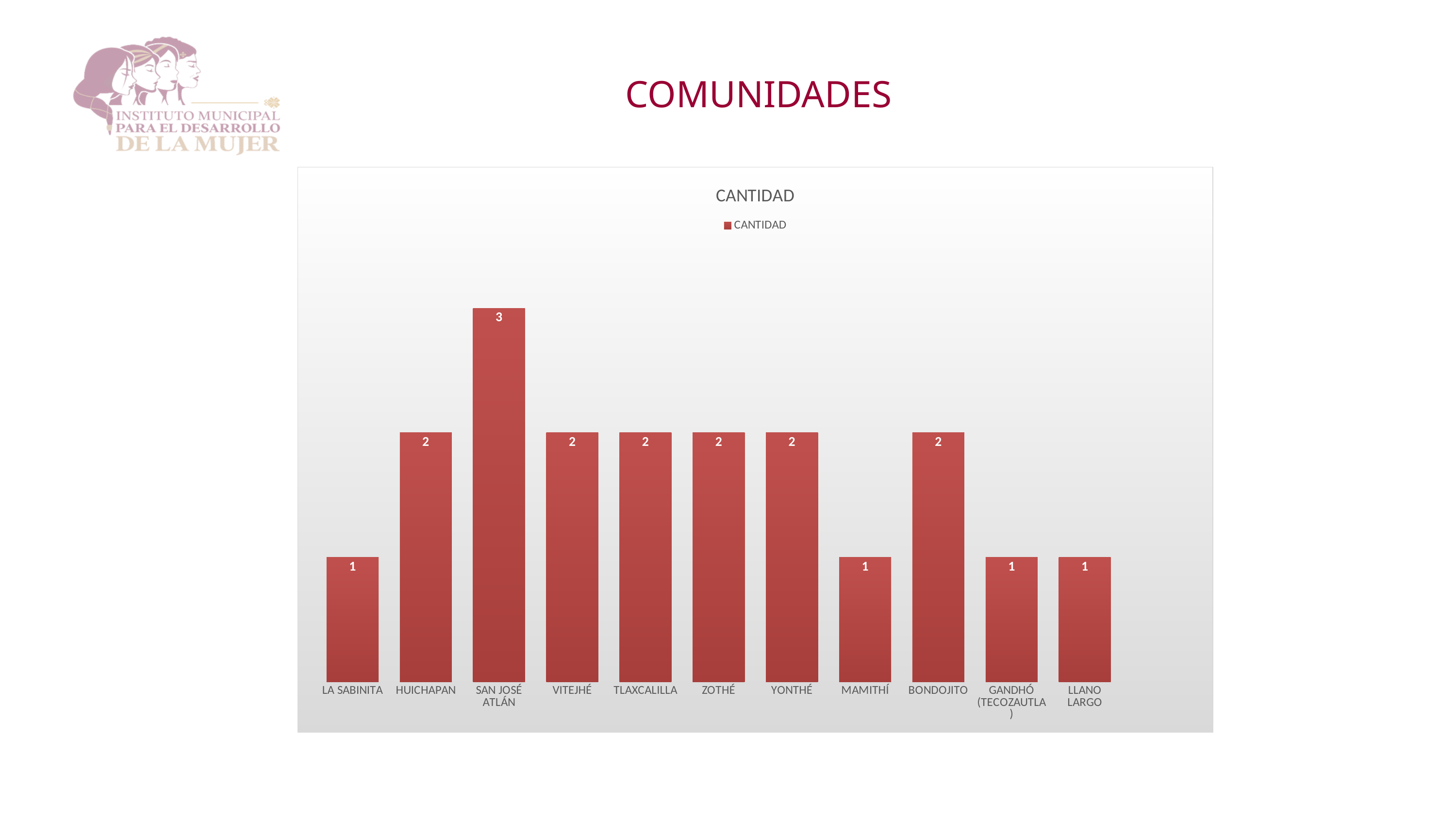
What is the value for SAN JOSÉ ATLÁN? 3 What is the difference between the values for HUICHAPAN and LLANO LARGO? 1 What kind of chart is shown? bar chart What is the value for BONDOJITO? 2 Which is larger, the value for ZOTHÉ or the value for MAMITHÍ? ZOTHÉ What is the title of the chart? CANTIDAD What is the value for GANDHÓ (TECOZAUTLA)? 1 Which category has the highest value? SAN JOSÉ ATLÁN What is the value for LA SABINITA? 1 How many series does the legend list? 1 How many categories are shown on the x axis? 11 What is the difference between the values for SAN JOSÉ ATLÁN and MAMITHÍ? 2